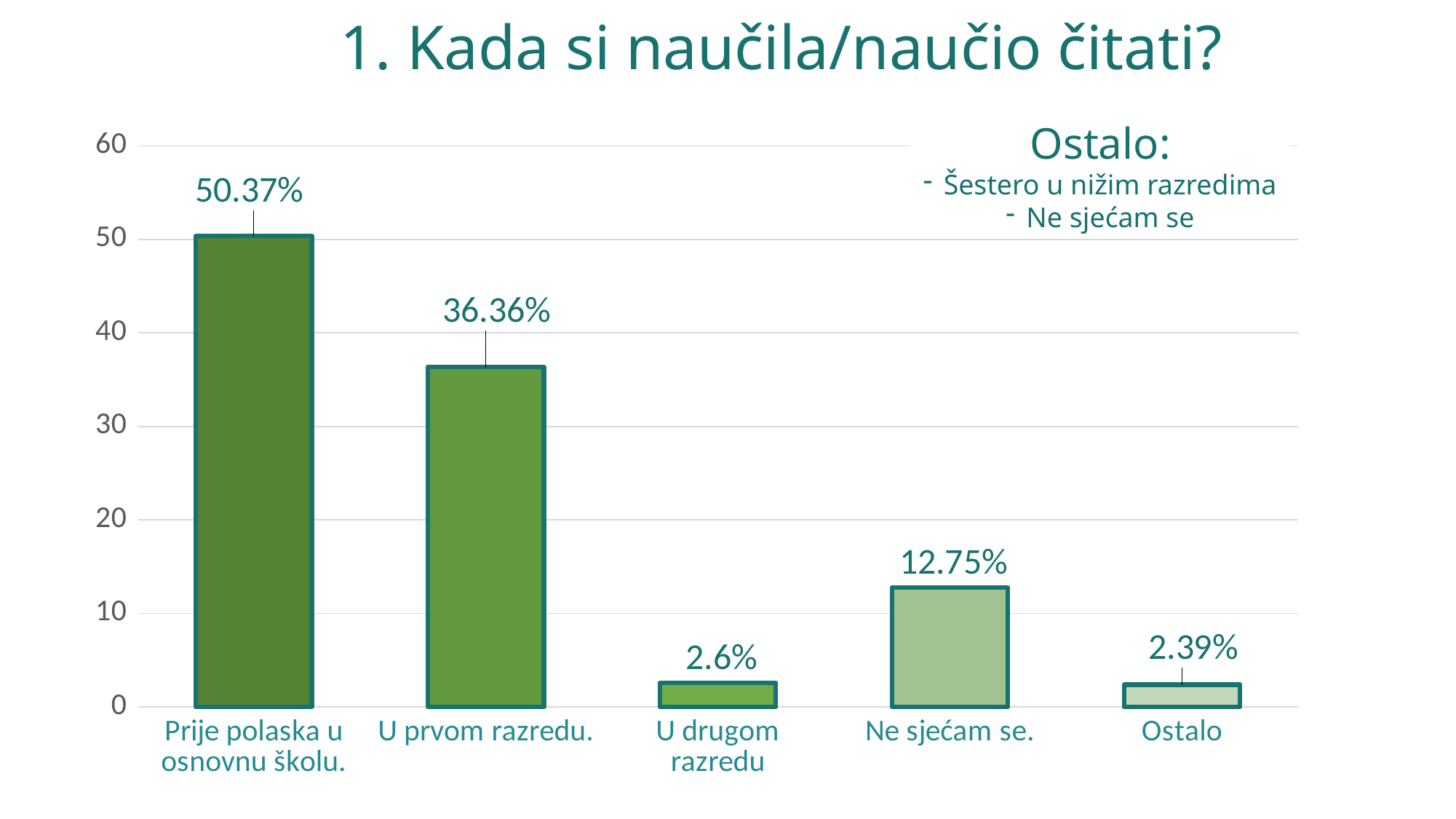
Which category has the lowest value? Ostalo What is the value for "U prvom razredu."? 36.36% Is the value for "U prvom razredu." greater or less than 40? less How many categories are shown on the x axis? 5 What kind of chart is shown on the slide? bar chart Which category has the highest value? Prije polaska u osnovnu školu. What is the value for "Prije polaska u osnovnu školu."? 50.37% What is the difference between the values for "Prije polaska u osnovnu školu." and "U prvom razredu."? 14.01% What is the value for "Ne sjećam se."? 12.75% Which is larger, the value for "U drugom razredu" or the value for "Ne sjećam se."? Ne sjećam se. What is the title of the chart? 1. Kada si naučila/naučio čitati? What is the value for "Ostalo"? 2.39%